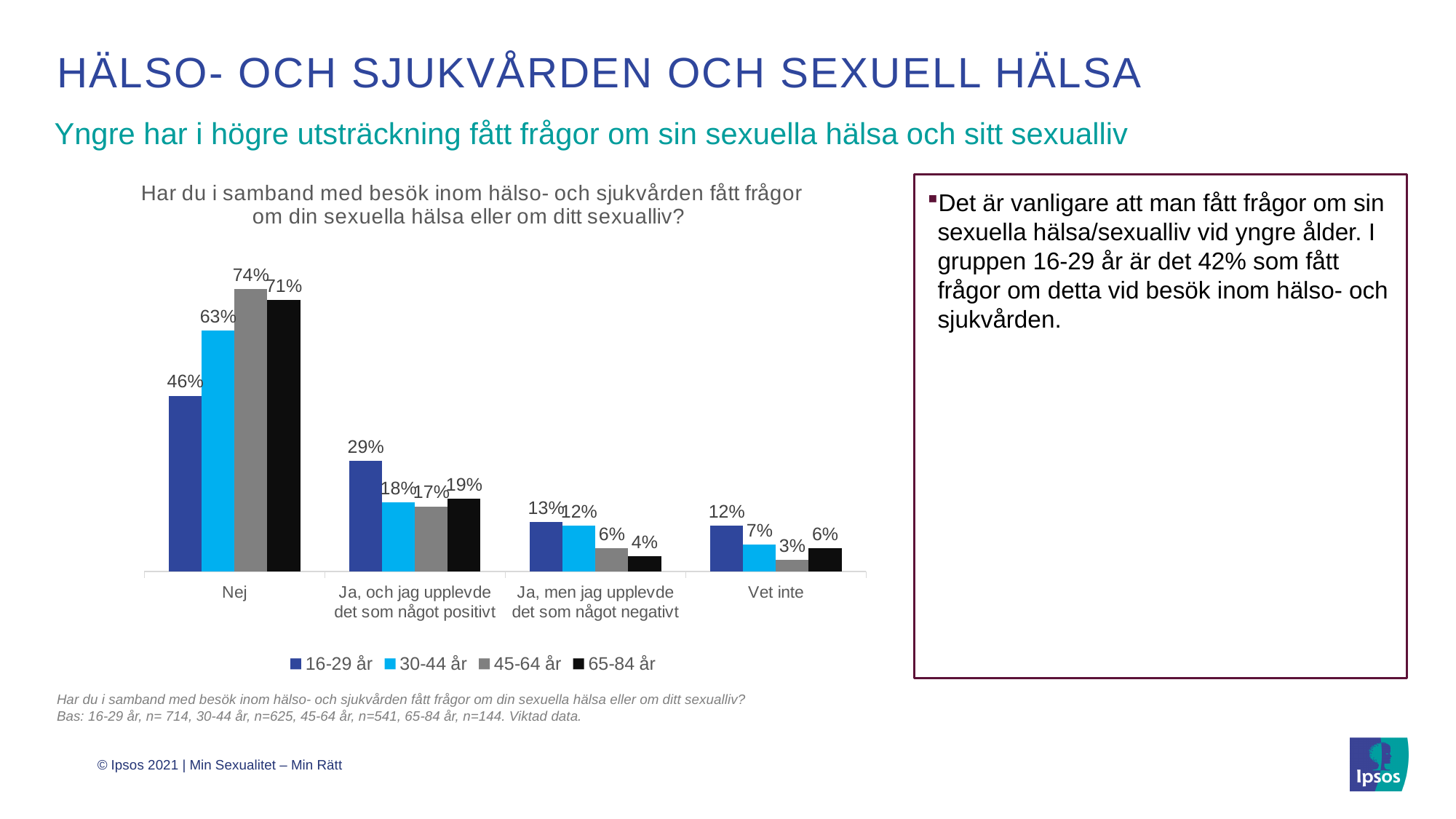
In the 'Nej' category, which is larger: the value for 16-29 år or the value for 30-44 år? 30-44 år How many categories are shown on the x axis? 4 What is the value for 16-29 år in the 'Nej' category? 46% How many series does the legend list? 4 What is the value for 30-44 år in the 'Vet inte' category? 7% What is the value for 65-84 år in the 'Ja, men jag upplevde det som något negativt' category? 4% Which age group has the highest value in the 'Nej' category? 45-64 år What type of chart is shown on the slide? bar chart What is the difference between the 16-29 år and 30-44 år values in the 'Ja, och jag upplevde det som något positivt' category? 11 percentage points What is the value for 45-64 år in the 'Nej' category? 74% Which series is shown in black in the legend? 65-84 år Which age group has the lowest value in the 'Vet inte' category? 45-64 år